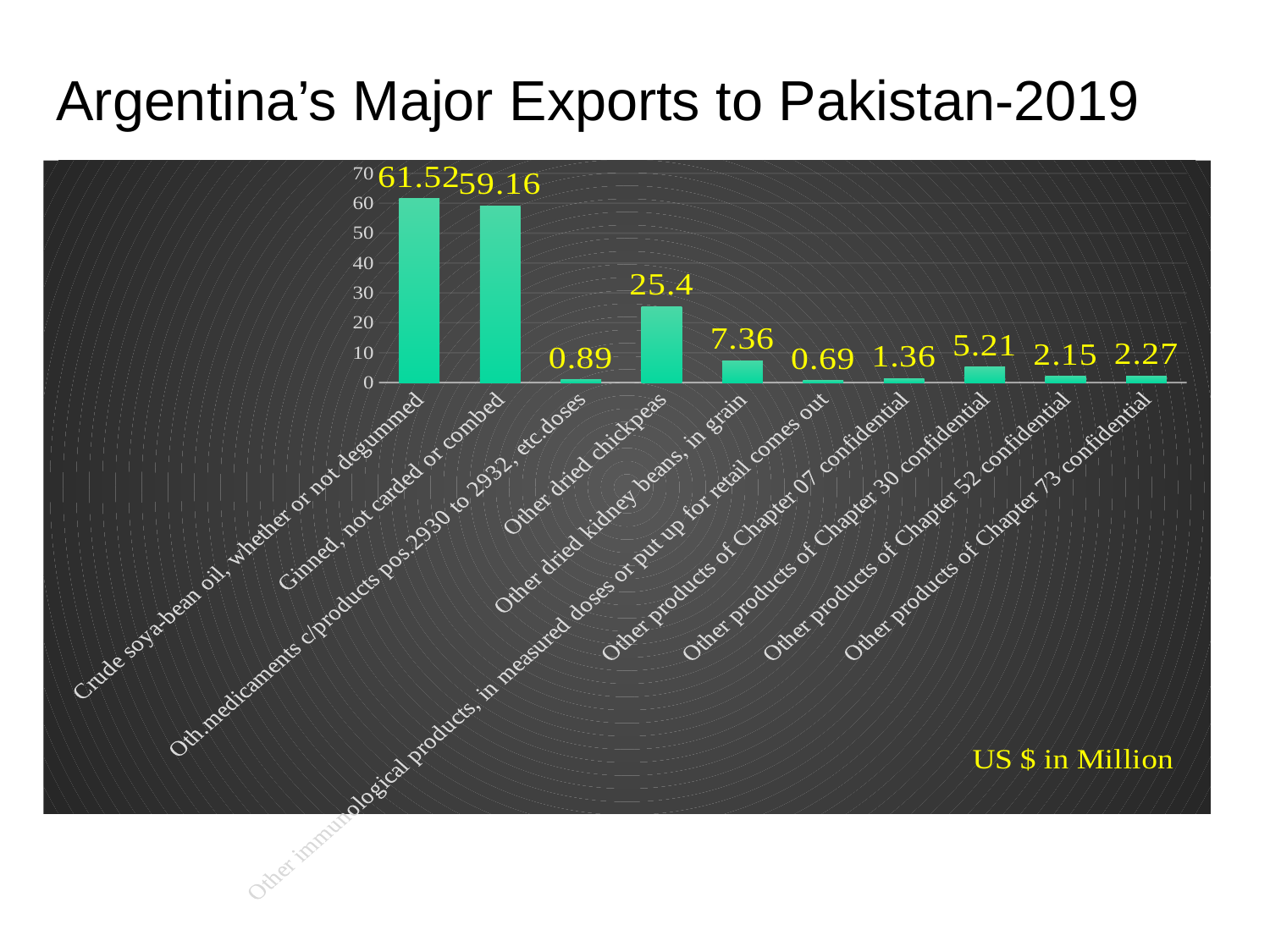
What is the value for Crude soya-bean oil, whether or not degummed? 61.52 Which is larger, the value for Other products of Chapter 52 confidential or Other products of Chapter 73 confidential? Other products of Chapter 73 confidential How many categories are shown in the chart? 10 Which category has the highest value? Crude soya-bean oil, whether or not degummed What is the value for Other dried chickpeas? 25.4 What kind of chart is shown on the slide? bar chart Which category has the lowest value? Other immunological products, in measured doses or put up for retail comes out What is the value for Other dried kidney beans, in grain? 7.36 What is the value for Other products of Chapter 30 confidential? 5.21 What is the difference between the values for Crude soya-bean oil, whether or not degummed and Ginned, not carded or combed? 2.36 Is the value for Other dried chickpeas greater or less than 30? less What unit is stated for the values in the chart? US $ in Million